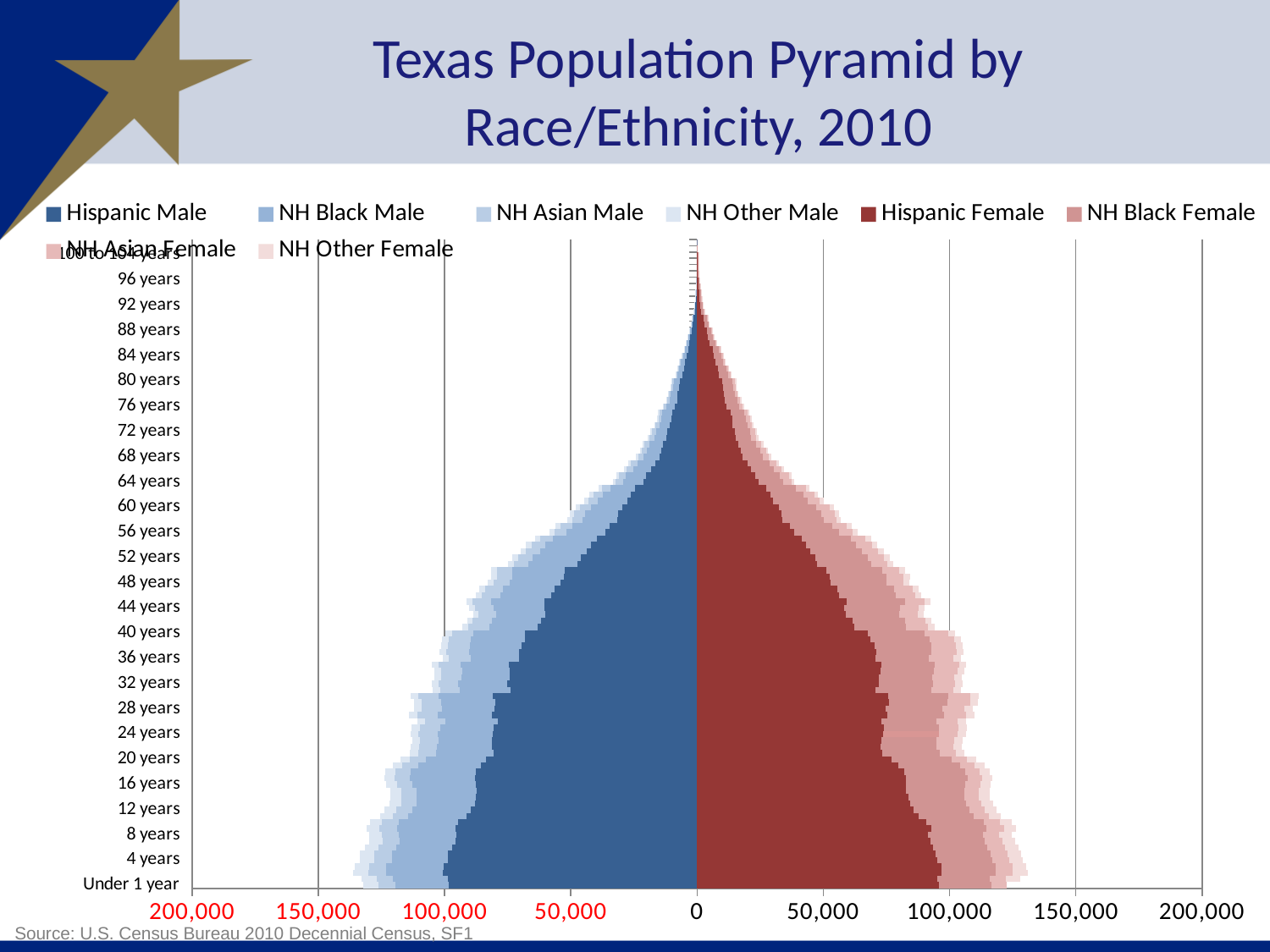
Which is larger, the Hispanic Male value for Under 1 year or the Hispanic Male value for 76 years? Under 1 year Is the total male population (all series combined) for Under 1 year greater or less than 100,000? greater Is the Hispanic Male value for Under 1 year greater or less than 50,000? greater What is the title of the chart? Texas Population Pyramid by Race/Ethnicity, 2010 Do the Hispanic Male values generally rise or fall as age increases from 40 years to 100 to 104 years? fall What kind of chart is shown on the slide? bar chart How many series does the legend list? 8 Which series is shown in the darkest blue on the left side of the pyramid? Hispanic Male Is the Hispanic Female value for Under 1 year greater or less than 50,000? greater